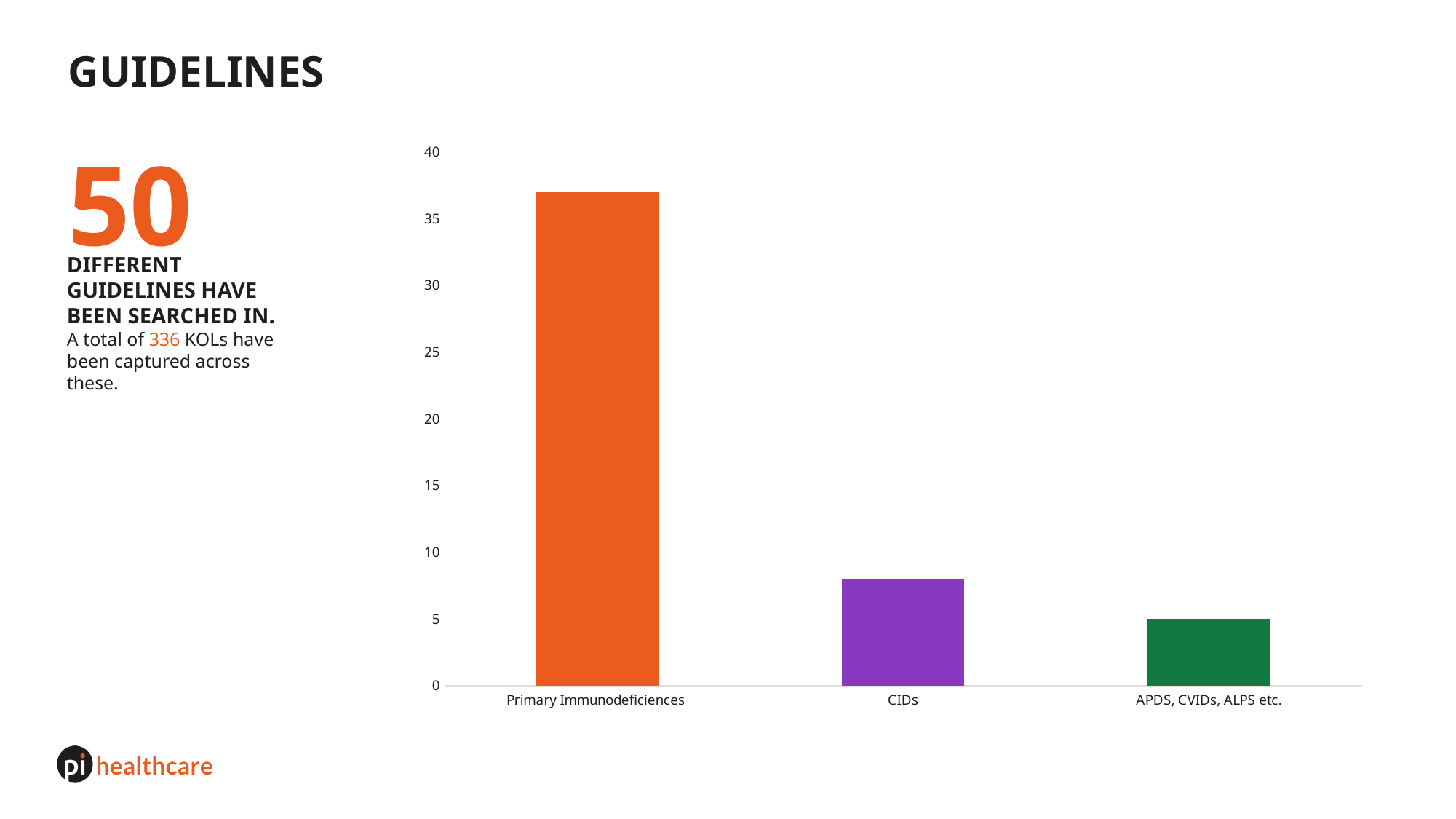
How many categories are shown on the x axis of the chart? 3 Do the bar values rise or fall from left to right along the x axis? fall What is the value for APDS, CVIDs, ALPS etc.? 5 Is the value for CIDs greater or less than 10? less Which category has the lowest bar in the chart? APDS, CVIDs, ALPS etc. Which is larger, the value for CIDs or the value for APDS, CVIDs, ALPS etc.? CIDs What is the maximum value shown on the vertical axis of the chart? 40 Is the value for Primary Immunodeficiences greater or less than 35? greater Which category has the highest bar in the chart? Primary Immunodeficiences What kind of chart is shown on the slide? bar chart Is the value for Primary Immunodeficiences greater or less than 40? less What colour is the bar for CIDs? purple